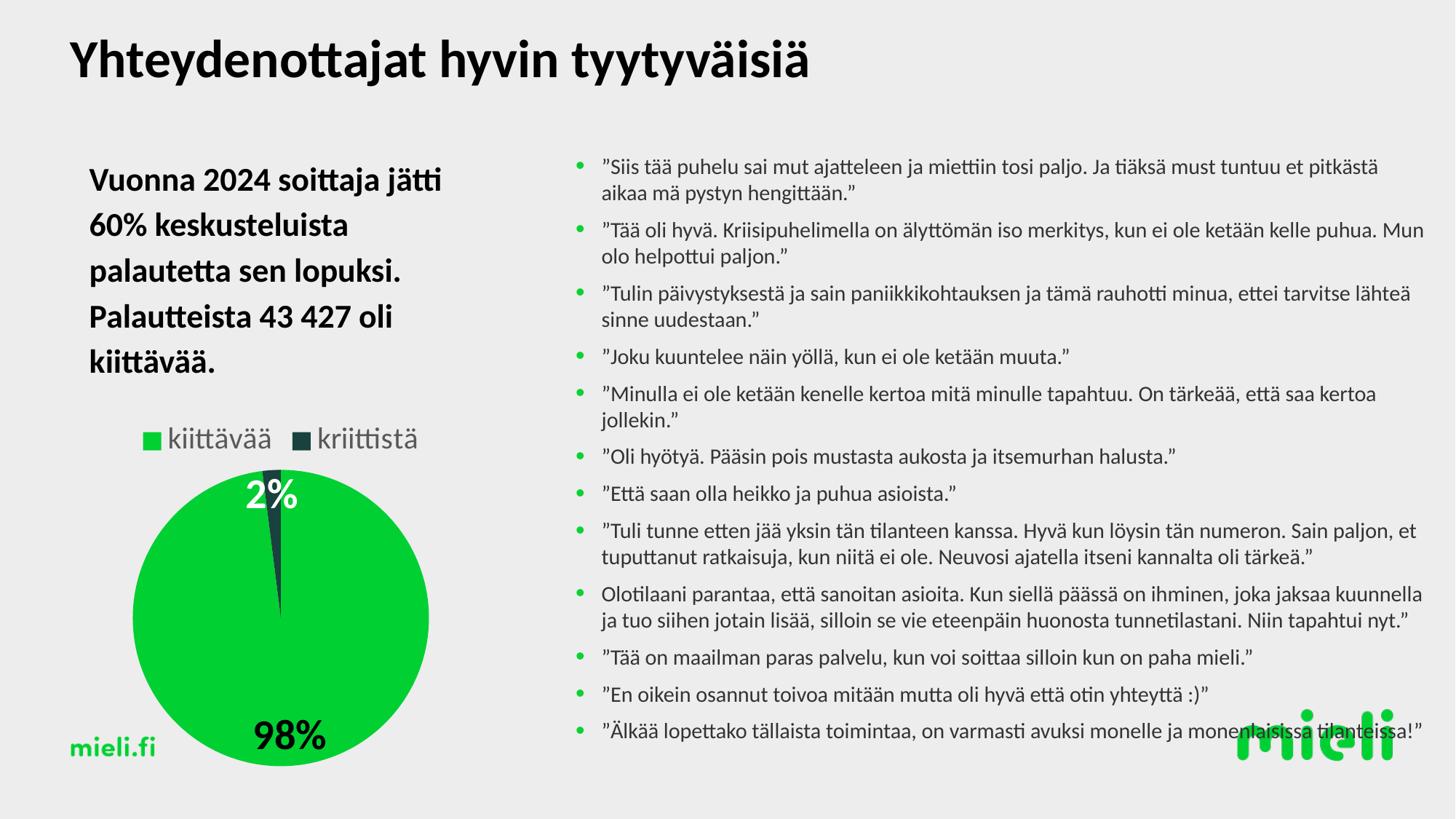
How many slices does the pie chart have? 2 What colour is the "kriittistä" slice? dark grey-green Which slice of the pie is the smallest? kriittistä What share of the pie does "kriittistä" represent? 2% What kind of chart is shown on the slide? pie chart What share of the pie does "kiittävää" represent? 98% How many entries does the legend list? 2 Which slice of the pie is the largest? kiittävää Which is larger, the "kiittävää" slice or the "kriittistä" slice? kiittävää What is the difference in percentage points between the "kiittävää" and "kriittistä" slices? 96 percentage points What colour is the "kiittävää" slice? green